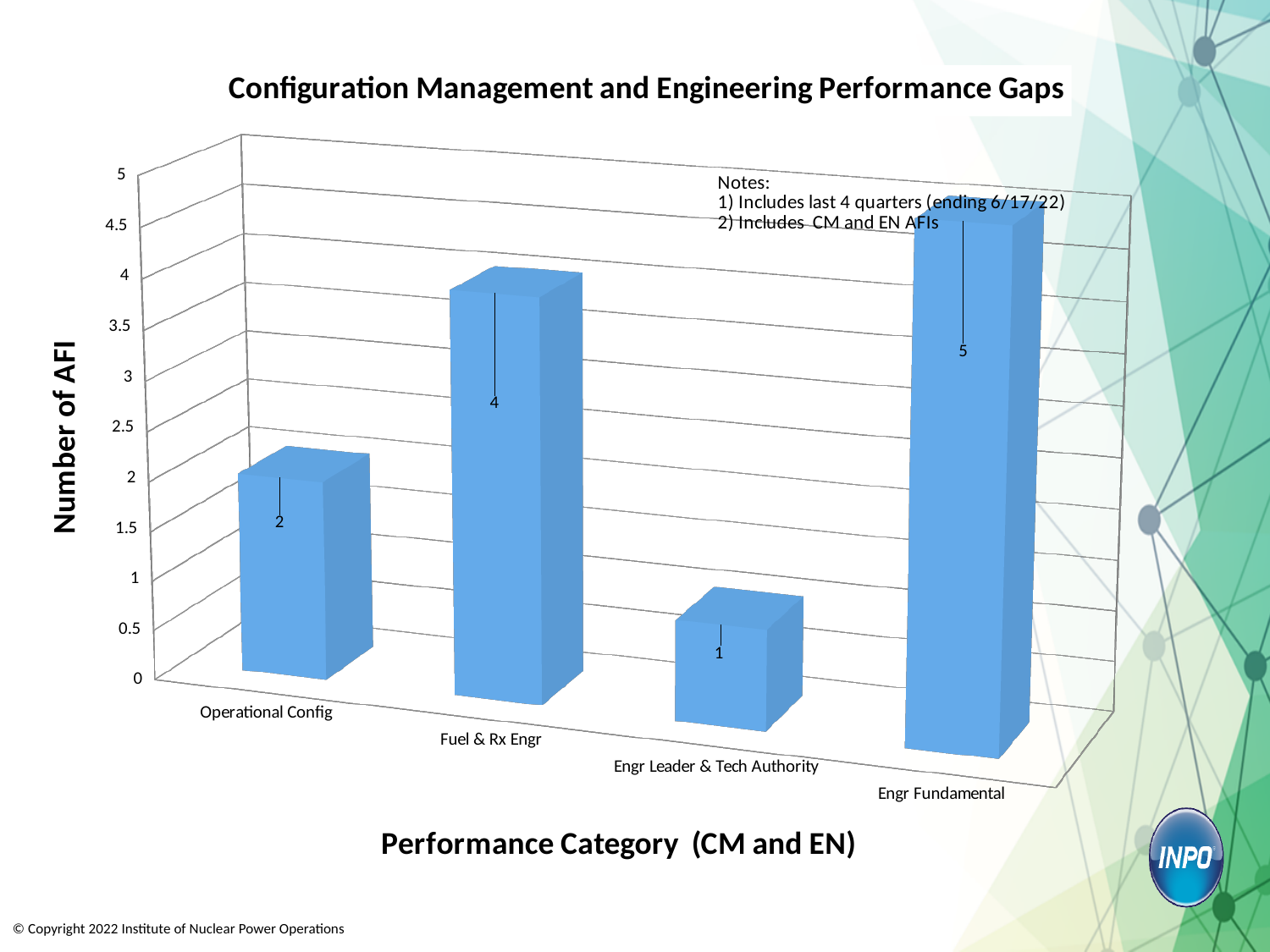
What is the number of AFI for Operational Config? 2 What is the number of AFI for Engr Fundamental? 5 Is the number of AFI for Fuel & Rx Engr greater or less than 3? greater What is the title of the chart? Configuration Management and Engineering Performance Gaps Which performance category has the highest number of AFI? Engr Fundamental What kind of chart is shown on the slide? bar chart How many performance categories are shown on the x axis? 4 What is the difference in number of AFI between Engr Fundamental and Operational Config? 3 What is the number of AFI for Fuel & Rx Engr? 4 What is the number of AFI for Engr Leader & Tech Authority? 1 Which performance category has the lowest number of AFI? Engr Leader & Tech Authority Which has more AFIs, Fuel & Rx Engr or Operational Config? Fuel & Rx Engr